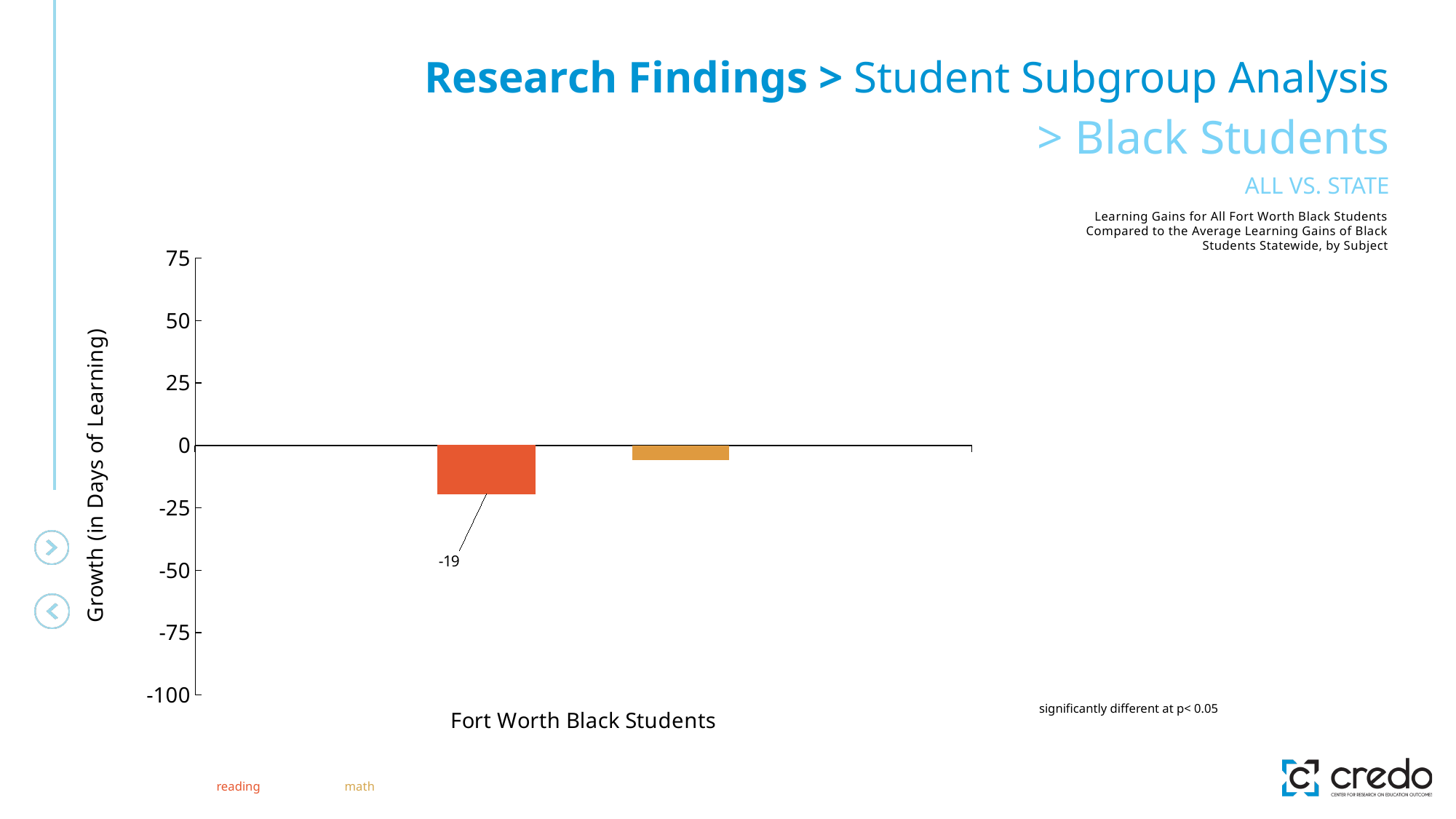
How many series does the legend list? 2 What kind of chart is shown on the slide? bar chart What is the label of the category on the x axis? Fort Worth Black Students How many categories are shown on the x axis? 1 Is the value for reading greater or less than -25? greater Is the value for math greater or less than -25? greater Which series has the lowest value, reading or math? reading Is the value for math greater or less than 0? less Which of the two values is larger, reading or math? math Which series has the highest value, reading or math? math What is the title of the y axis? Growth (in Days of Learning) What is the value for reading for Fort Worth Black Students? -19